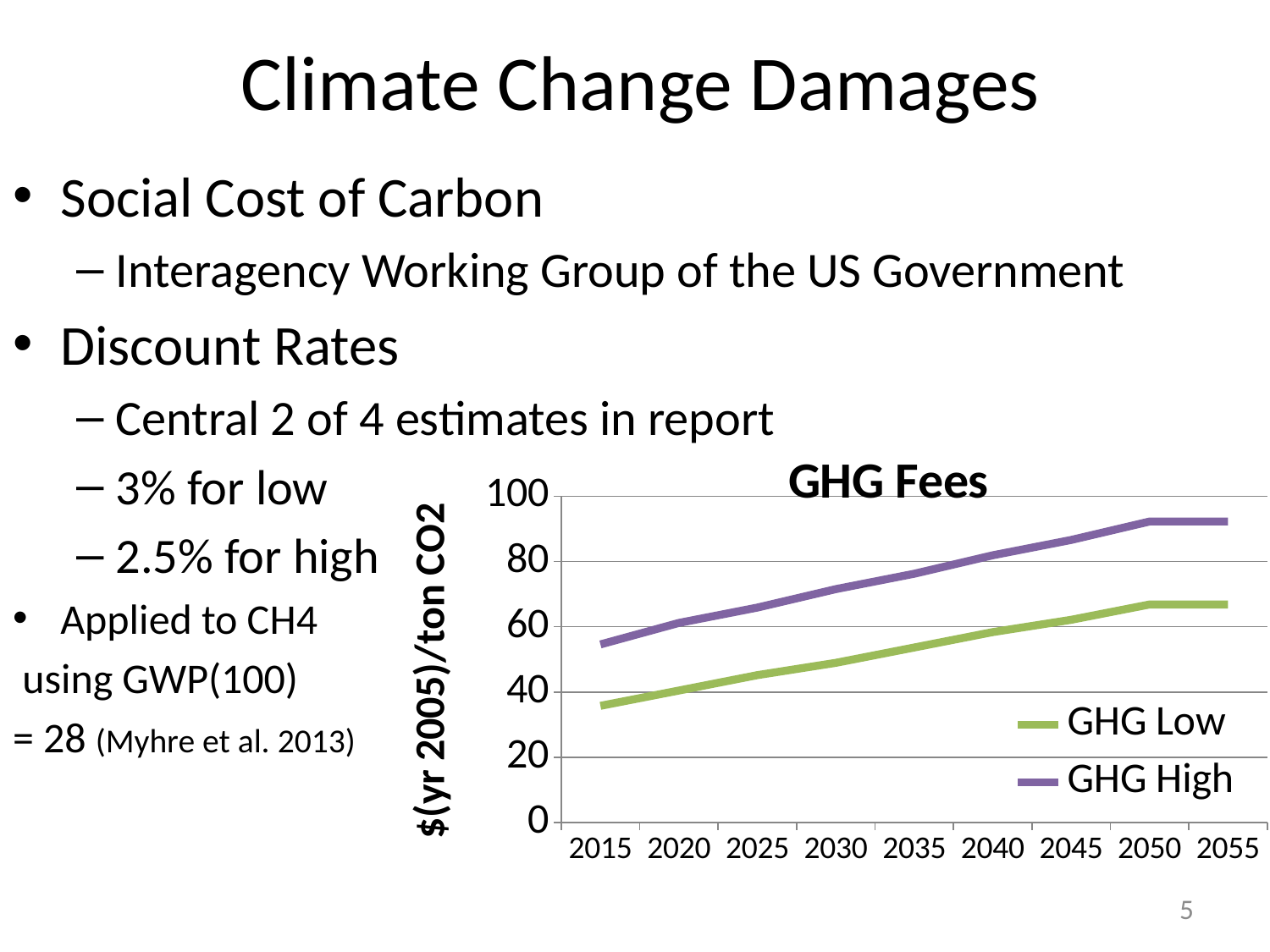
Is the GHG High value for 2030 greater or less than 60? greater How many series does the legend of the GHG Fees chart list? 2 What is the label on the y axis of the GHG Fees chart? $(yr 2005)/ton CO2 What kind of chart is the GHG Fees chart? line chart In 2030, which series has the larger value, GHG Low or GHG High? GHG High Does the GHG Low line rise or fall from 2015 to 2050? rise Is the GHG Low value for 2055 greater or less than 60? greater Is the GHG Low value for 2015 greater or less than 40? less How many years are marked along the x axis of the GHG Fees chart? 9 What is the title of the chart? GHG Fees